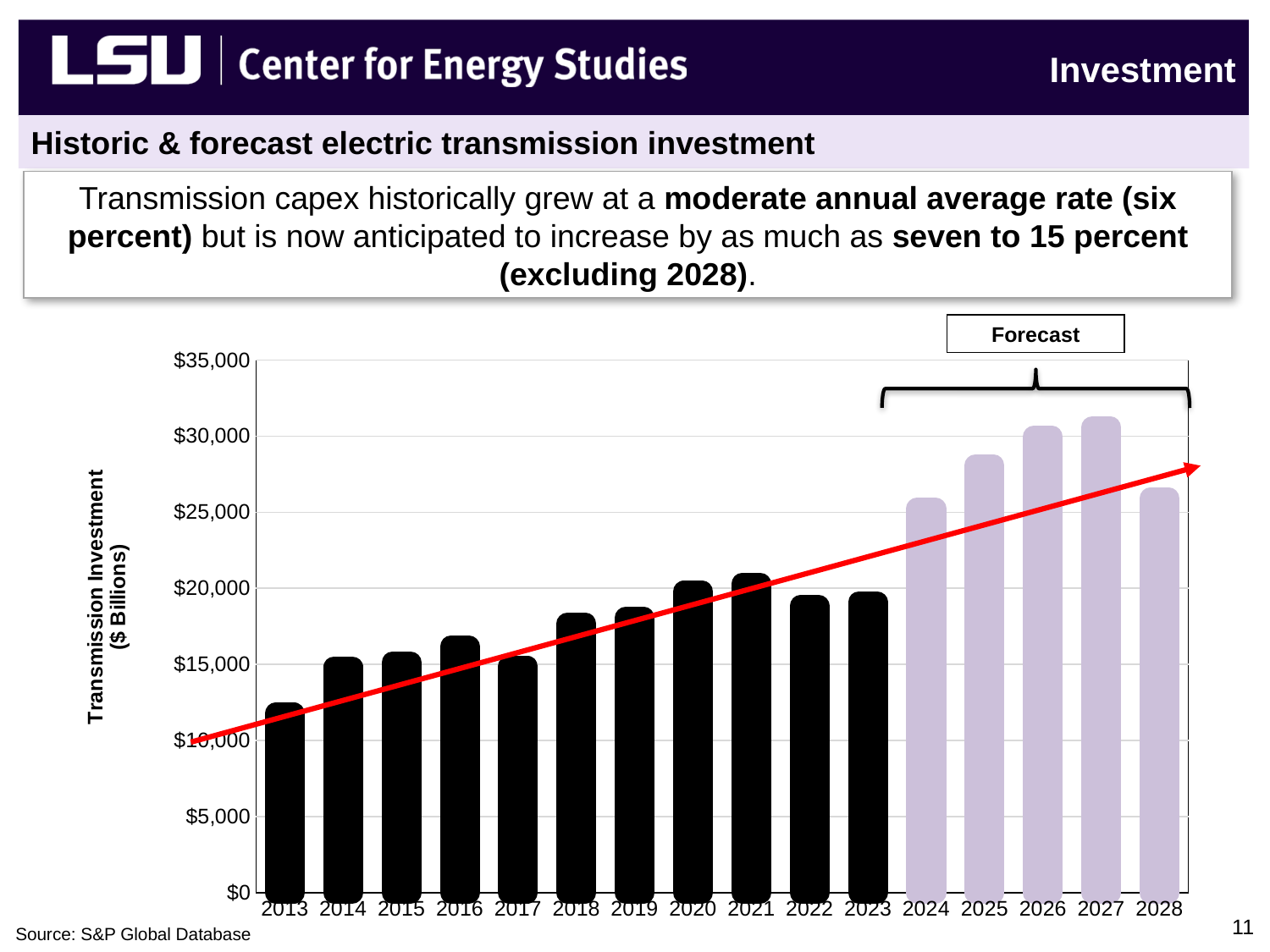
Is the value for 2016 greater or less than $15,000? greater Is the value for 2025 greater or less than $30,000? less Which is larger, the value for 2027 or the value for 2028? 2027 Which years are marked as the forecast period in the chart? 2024 to 2028 Is the value for 2028 greater or less than $30,000? less What kind of chart is shown on the slide? bar chart Which year has the lowest transmission investment in the chart? 2013 How many years are plotted on the x axis of the chart? 16 Do the values generally rise or fall from 2013 to 2023? rise Which is larger, the value for 2023 or the value for 2024? 2024